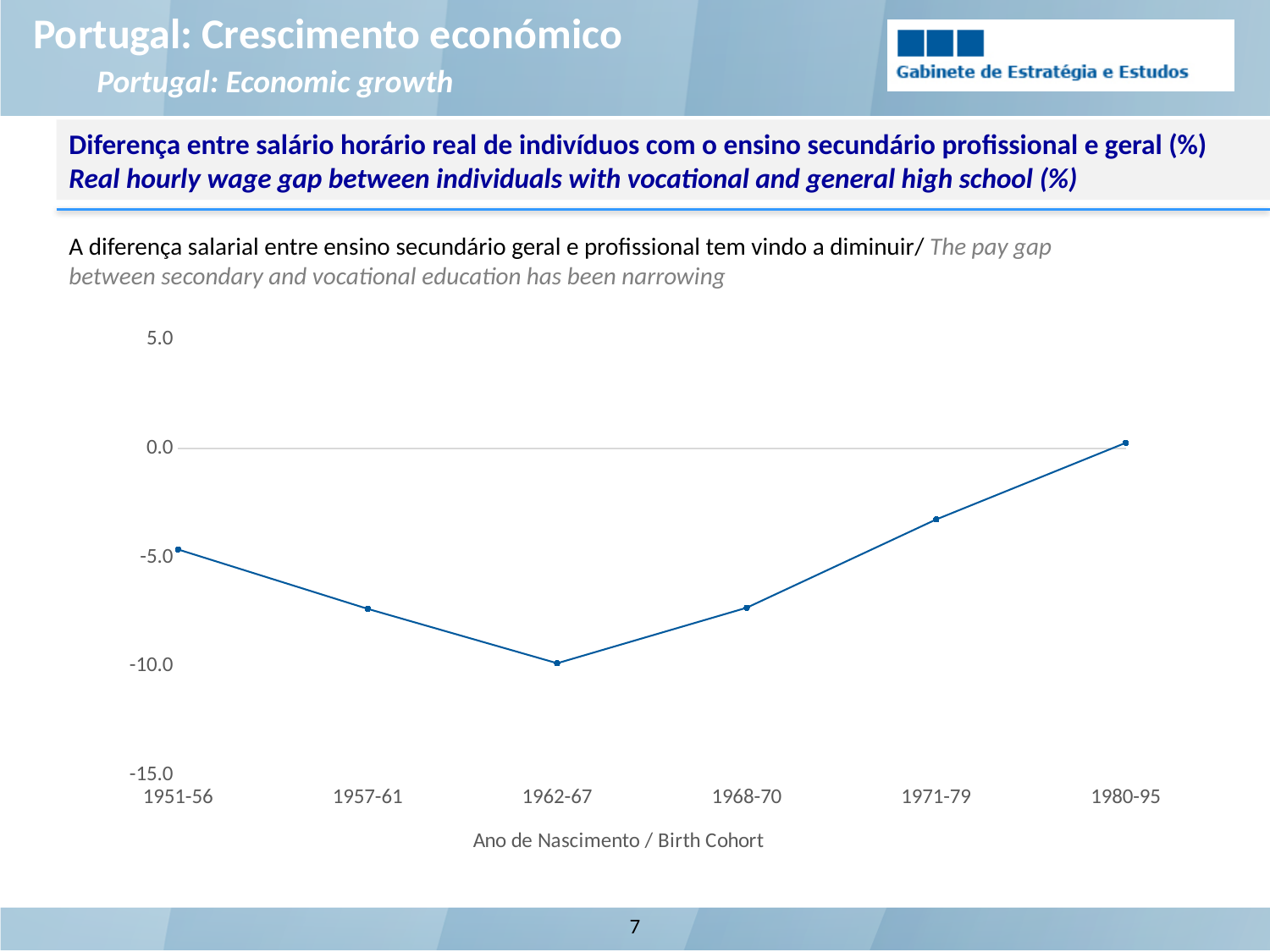
Which has the larger value, the 1951-56 cohort or the 1962-67 cohort? 1951-56 Which birth cohort has the highest wage gap value? 1980-95 What kind of chart is shown on the slide? line chart What is the title of the x axis? Ano de Nascimento / Birth Cohort Is the value for the 1968-70 cohort greater or less than -5.0? less Which birth cohort has the lowest (most negative) wage gap? 1962-67 Which has the larger value, the 1957-61 cohort or the 1971-79 cohort? 1971-79 How many birth cohorts are plotted on the x axis? 6 Is the value for the 1957-61 cohort greater or less than -5.0? less Do the values rise or fall from the 1962-67 cohort to the 1980-95 cohort? rise Is the value for the 1980-95 cohort greater or less than -5.0? greater